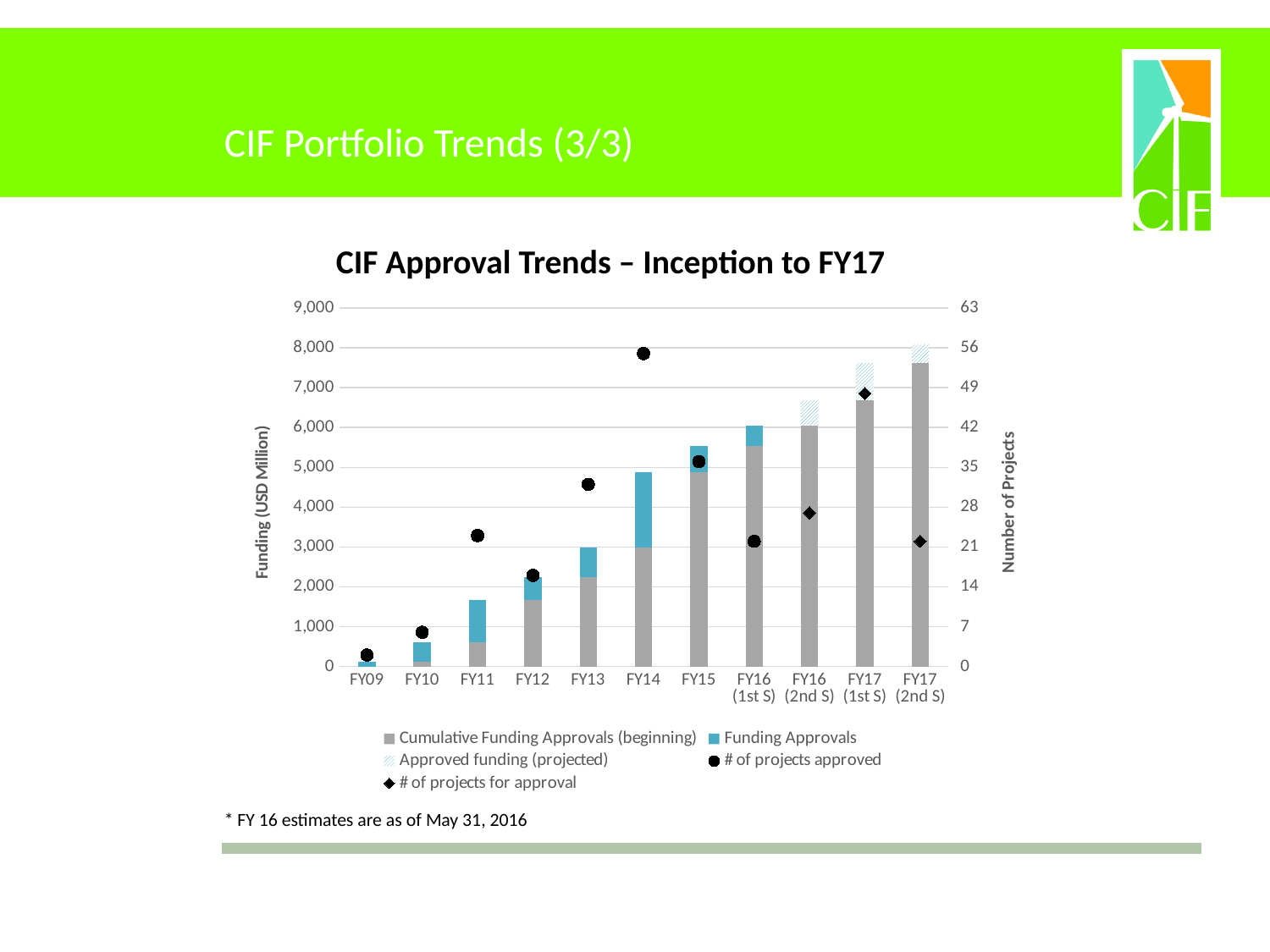
Which category has the highest value for # of projects approved? FY14 Which is larger, the # of projects approved for FY14 or for FY13? FY14 How many series does the legend list? 5 How many fiscal-year categories are shown on the x axis? 11 Is the Cumulative Funding Approvals (beginning) value for FY17 (2nd S) greater or less than 7,000? greater Is the # of projects approved for FY14 greater or less than 49? greater What kind of chart is used to show the funding series? bar chart Is the total stacked funding bar for FY15 greater or less than 5,000? greater Do the Cumulative Funding Approvals (beginning) values rise or fall from FY09 to FY17 (2nd S)? rise Which category has the lowest value for Cumulative Funding Approvals (beginning)? FY10 What is the title of the chart? CIF Approval Trends – Inception to FY17